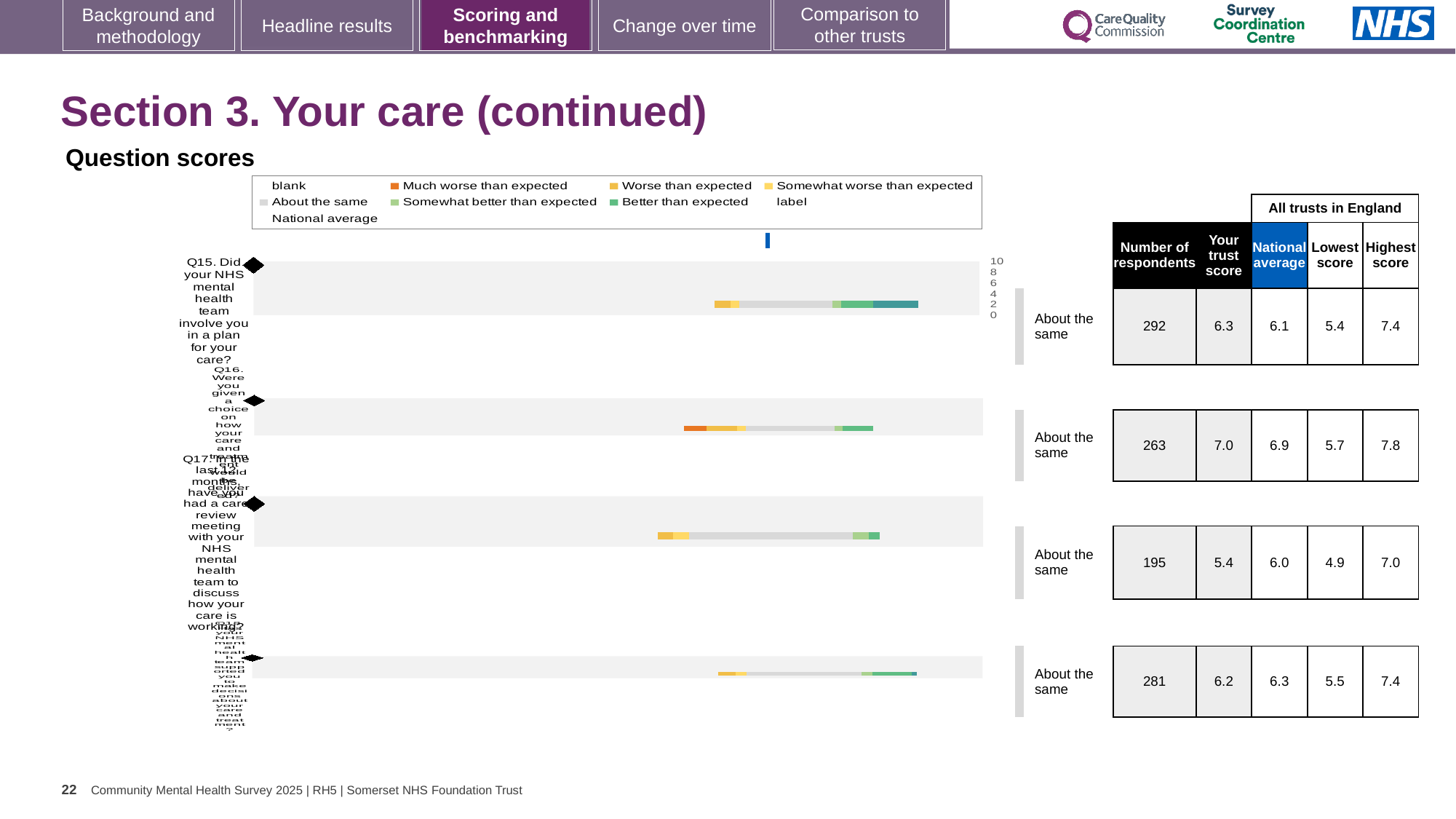
How many question rows (bars) are plotted in the question scores chart? 4 What is the national average score for Q17 (care review meeting)? 6.0 How many respondents answered Q16? 263 Which of Q15, Q16 and Q17 has the lowest 'Your trust score'? Q17 Which of Q15, Q16 and Q17 has the highest 'Your trust score'? Q16 What kind of chart is used to show the question scores on this slide? bar chart For Q17, what is the difference between the national average and the trust score? 0.6 What is the 'Your trust score' value for Q15 (Did your NHS mental health team involve you in a plan for your care?)? 6.3 For Q16, is the trust score or the national average larger? trust score In the chart legend, which colour represents 'Much worse than expected'? orange What is the lowest score among all trusts in England for Q15? 5.4 What is the highest score among all trusts in England for Q17? 7.0